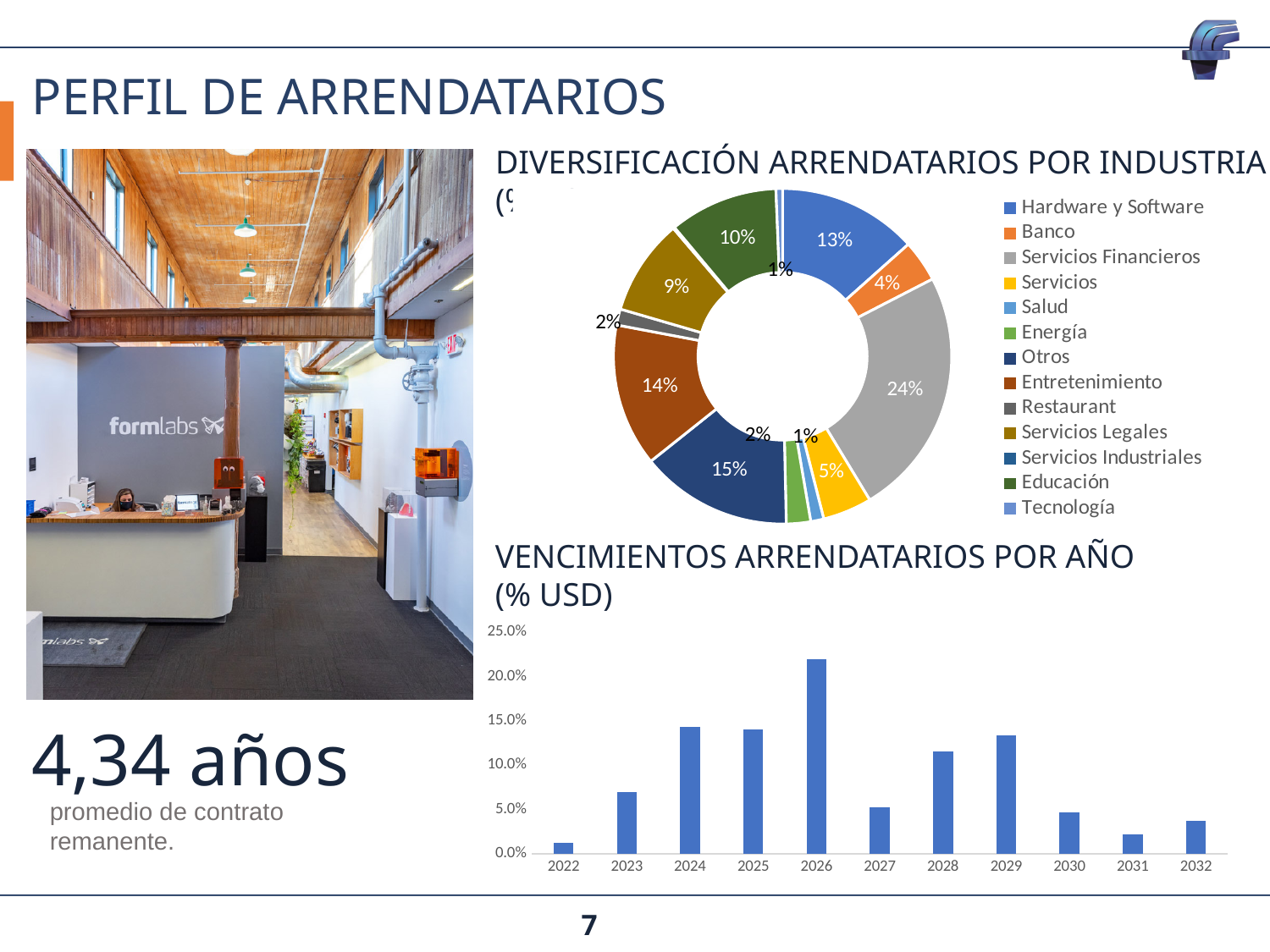
In the chart 'VENCIMIENTOS ARRENDATARIOS POR AÑO (% USD)', which year has the lowest value? 2022 In the chart 'VENCIMIENTOS ARRENDATARIOS POR AÑO (% USD)', which year has the highest value? 2026 In the chart 'VENCIMIENTOS ARRENDATARIOS POR AÑO (% USD)', is the value for 2026 greater or less than 20.0%? greater How many years are shown on the x axis of the chart 'VENCIMIENTOS ARRENDATARIOS POR AÑO (% USD)'? 11 In the chart 'DIVERSIFICACIÓN ARRENDATARIOS POR INDUSTRIA', what is the difference between the shares of Otros and Hardware y Software? 2% How many entries does the legend of the chart 'DIVERSIFICACIÓN ARRENDATARIOS POR INDUSTRIA' list? 13 In the chart 'DIVERSIFICACIÓN ARRENDATARIOS POR INDUSTRIA', what share does Entretenimiento have? 14% In the chart 'DIVERSIFICACIÓN ARRENDATARIOS POR INDUSTRIA', what share does Servicios Financieros have? 24% In the chart 'DIVERSIFICACIÓN ARRENDATARIOS POR INDUSTRIA', which has a larger share, Educación or Servicios Legales? Educación In the chart 'DIVERSIFICACIÓN ARRENDATARIOS POR INDUSTRIA', which industry has the largest share? Servicios Financieros What kind of chart is 'VENCIMIENTOS ARRENDATARIOS POR AÑO (% USD)'? Bar chart What kind of chart is 'DIVERSIFICACIÓN ARRENDATARIOS POR INDUSTRIA'? Donut (pie) chart